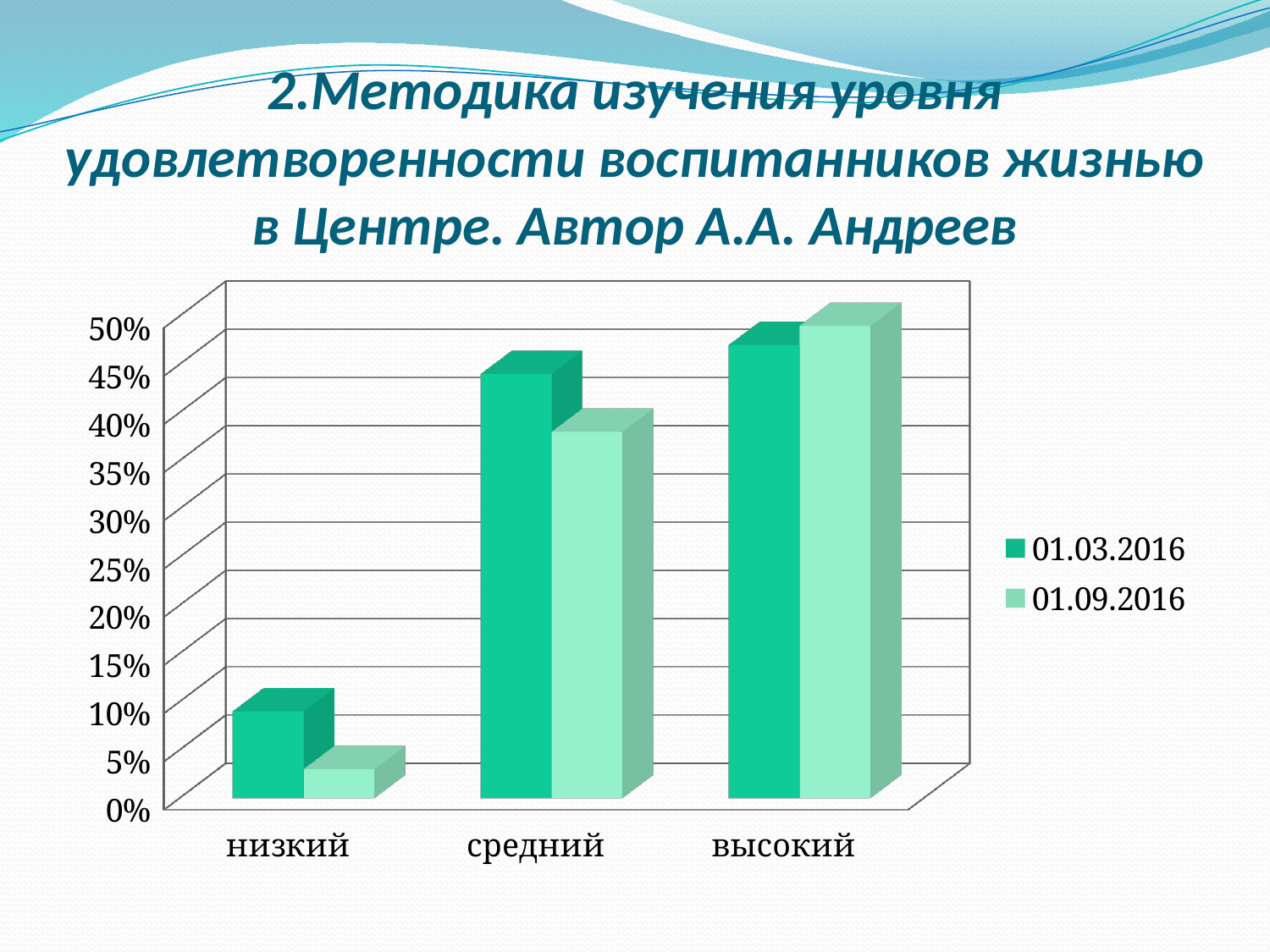
What kind of chart is shown on the slide? bar chart How many categories are shown on the x axis of the chart? 3 Do the values for the 01.09.2016 series rise or fall from низкий to высокий? rise Which category has the lowest value for the 01.03.2016 series? низкий For the низкий category, which series has the larger value, 01.03.2016 or 01.09.2016? 01.03.2016 Which category has the lowest value for the 01.09.2016 series? низкий For the средний category, which series has the larger value, 01.03.2016 or 01.09.2016? 01.03.2016 Which category has the highest value for the 01.09.2016 series? высокий How many series does the chart legend list? 2 Is the value for высокий in the 01.03.2016 series greater or less than 40%? greater Is the value for низкий in the 01.03.2016 series greater or less than 15%? less Is the value for средний in the 01.09.2016 series greater or less than 30%? greater